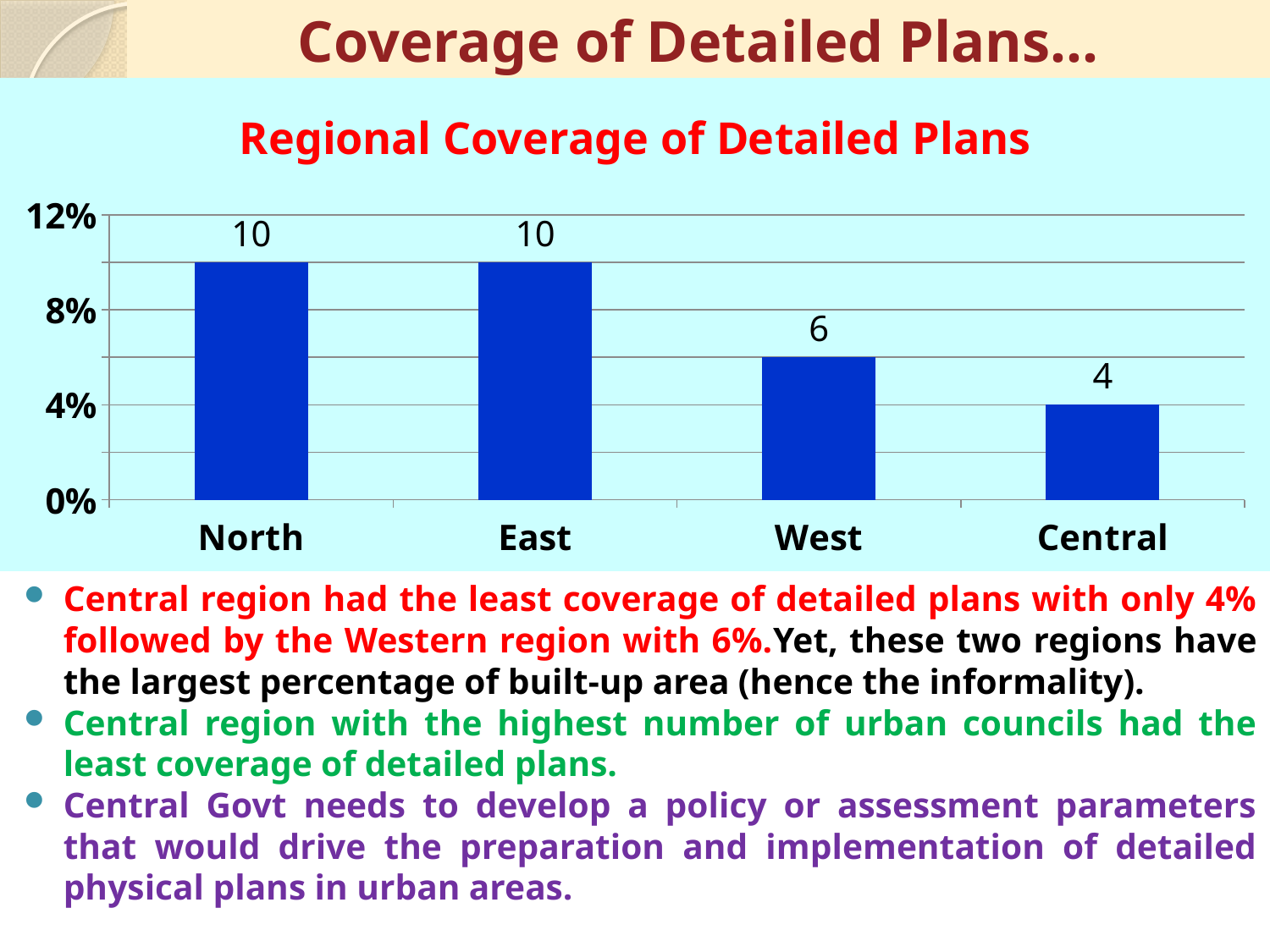
Which region has the lowest value in the Regional Coverage of Detailed Plans chart? Central What is the value for West in the Regional Coverage of Detailed Plans chart? 6 What is the title of the chart on the slide? Regional Coverage of Detailed Plans What kind of chart is the Regional Coverage of Detailed Plans chart? bar chart How many regions are shown in the Regional Coverage of Detailed Plans chart? 4 Do the values in the Regional Coverage of Detailed Plans chart rise or fall from North to Central? fall What is the difference between the values for East and West in the Regional Coverage of Detailed Plans chart? 4 What is the value for North in the Regional Coverage of Detailed Plans chart? 10 What is the difference between the values for West and Central in the Regional Coverage of Detailed Plans chart? 2 What is the value for Central in the Regional Coverage of Detailed Plans chart? 4 Which is larger in the Regional Coverage of Detailed Plans chart, the value for West or the value for Central? West Is the value for Central greater or less than 8% in the Regional Coverage of Detailed Plans chart? less